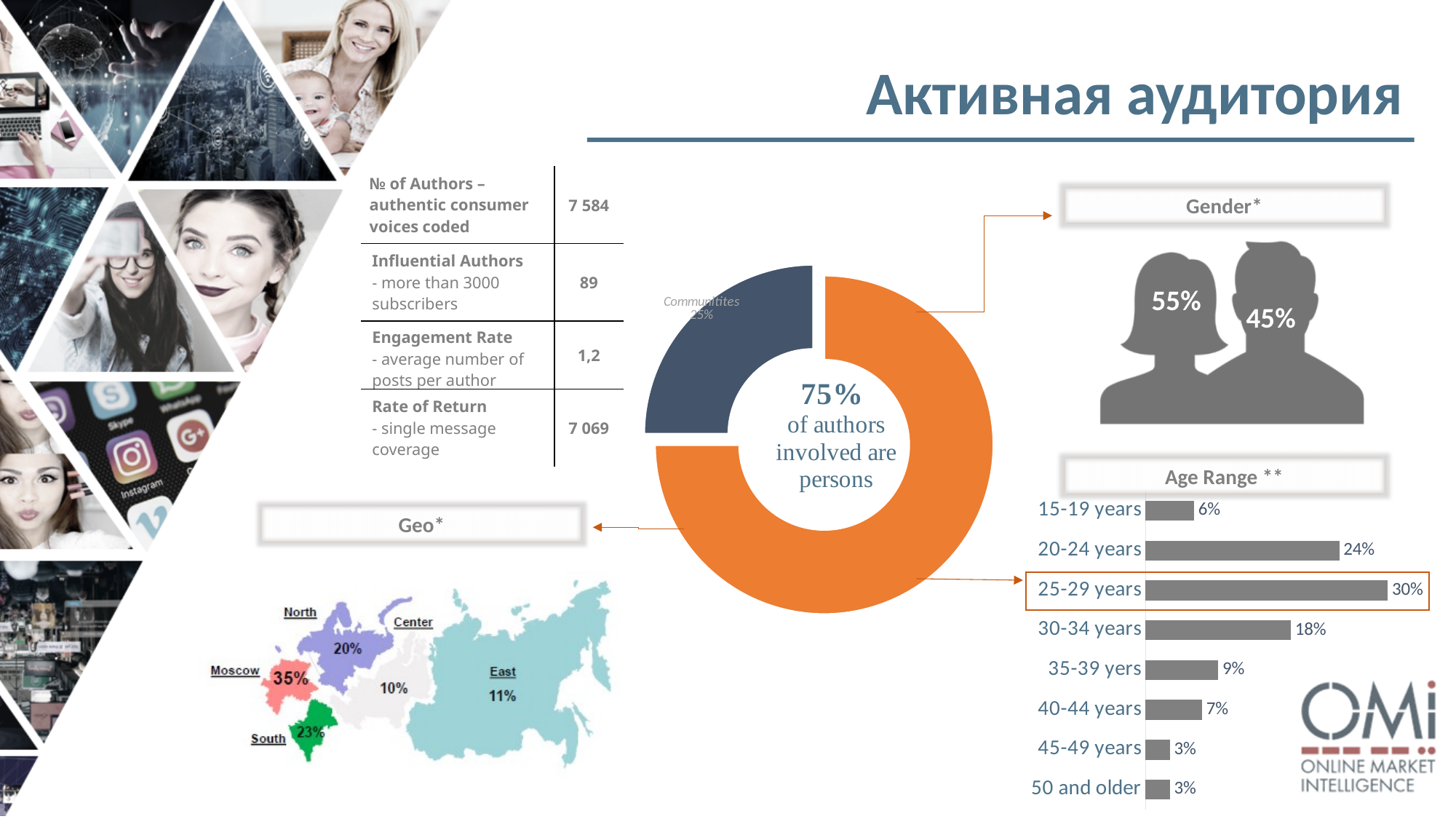
How many age groups are shown in the Age Range bar chart? 8 In the donut chart in the centre of the slide, what share of authors involved are persons? 75% In the Gender section, what is the percentage shown for the female figure? 55% In the Age Range bar chart, which is larger: the value for 35-39 years or the value for 40-44 years? 35-39 years In the Age Range bar chart, which age group has the highest value? 25-29 years What kind of chart is the Age Range chart? bar chart In the Age Range bar chart, what is the difference between the values for 20-24 years and 15-19 years? 18% In the Geo map, which region has the lowest value? Center In the Geo map, what is the value for Moscow? 35% In the Age Range bar chart, what is the value for 30-34 years? 18% In the Age Range bar chart, what is the value for 25-29 years? 30% In the donut chart in the centre of the slide, what share is labelled Communities? 25%